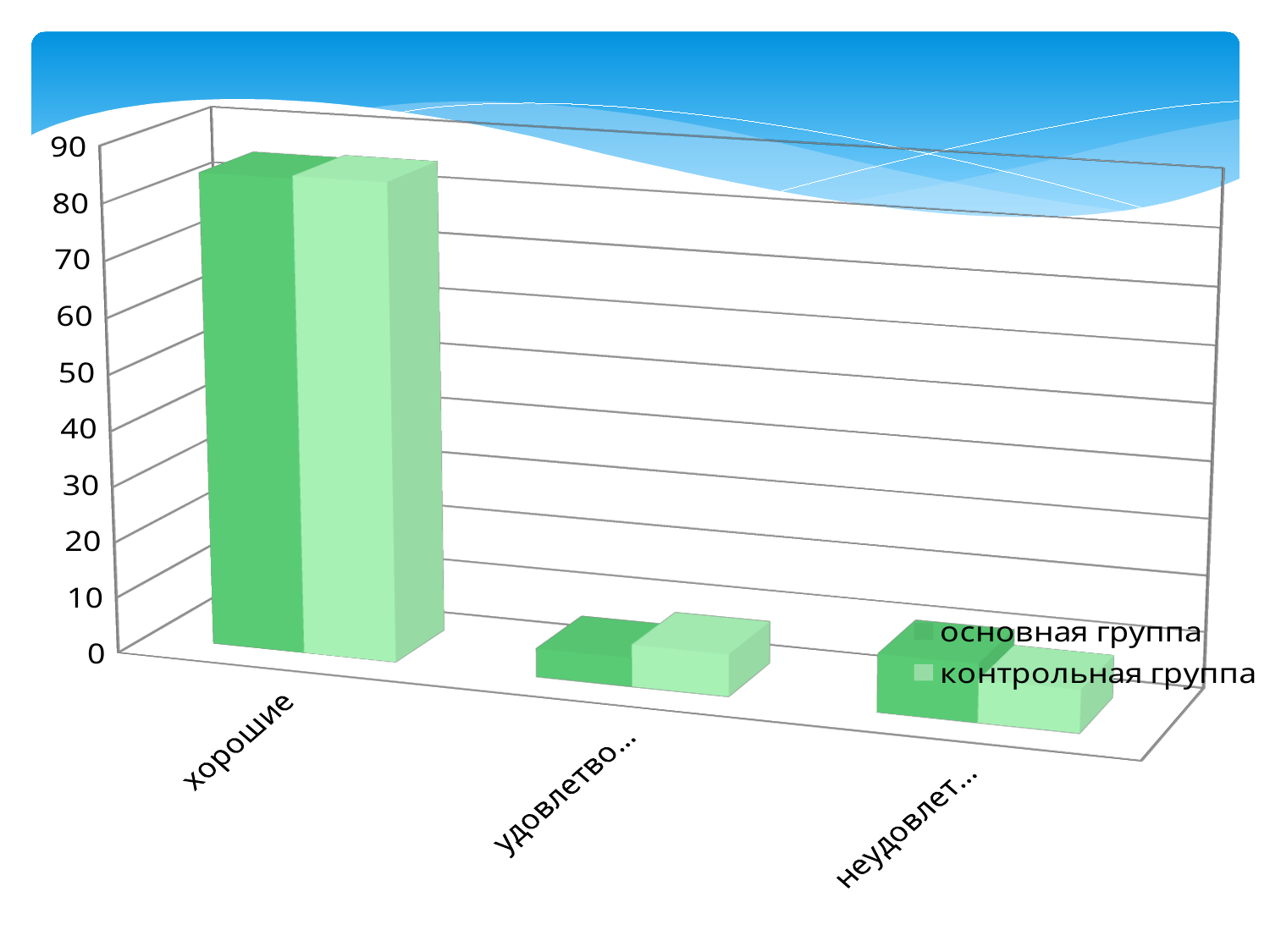
Which category has the highest value for основная группа? хорошие Is the value for удовлетво... in основная группа greater or less than 20? less Is the value for неудовлет... in контрольная группа greater or less than 30? less How many series does the legend list? 2 How many categories are shown on the x axis? 3 Is the value for хорошие in контрольная группа greater or less than 60? greater What is the highest value shown on the vertical axis? 90 What are the two series named in the legend? основная группа, контрольная группа What kind of chart is shown on the slide? bar chart For основная группа, which is larger: хорошие or неудовлет...? хорошие Which category has the highest value for контрольная группа? хорошие